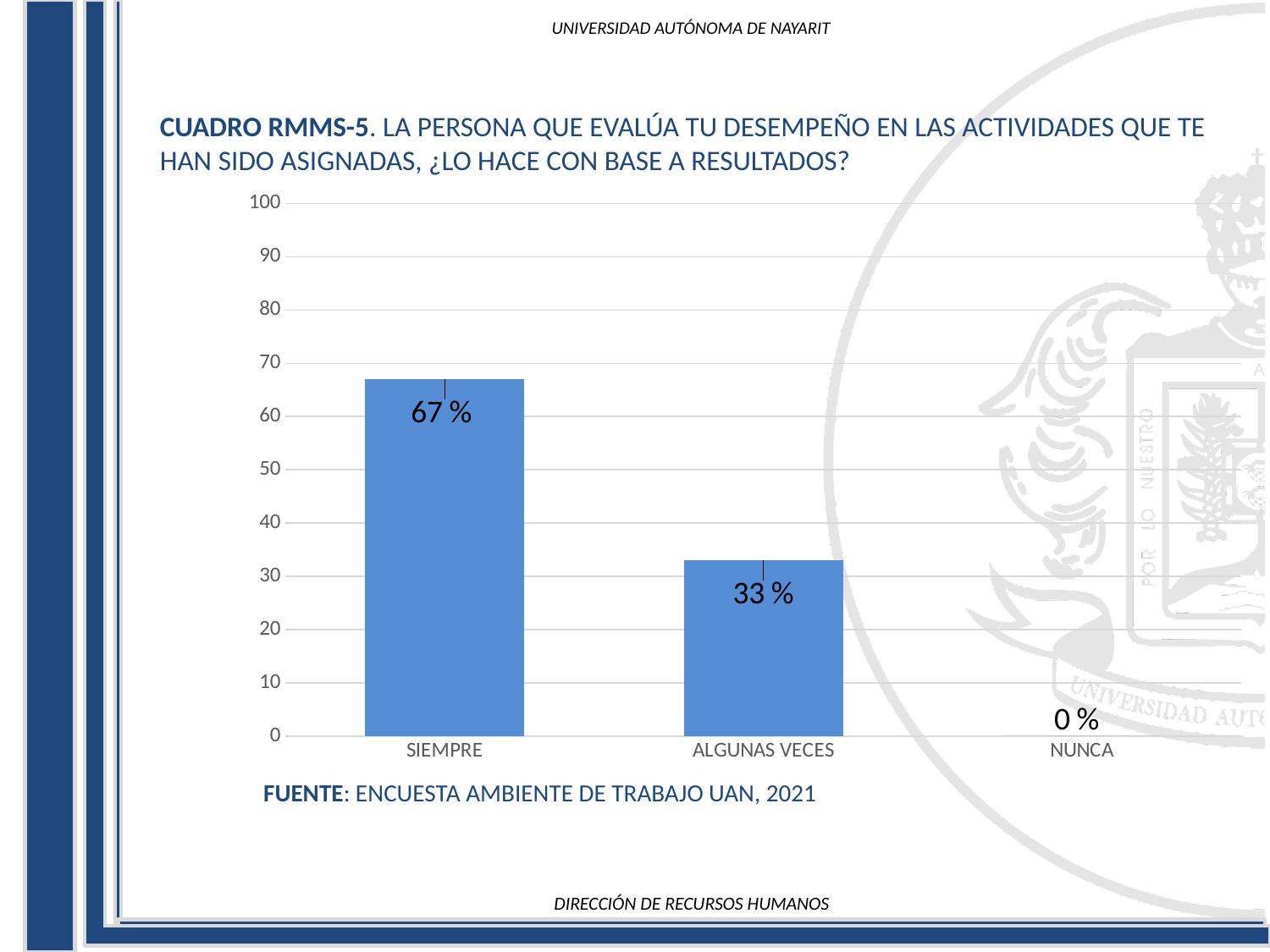
How many categories are shown on the x axis? 3 Which is larger, the value for SIEMPRE or the value for ALGUNAS VECES? SIEMPRE Is the value for SIEMPRE greater or less than 60? greater What is the value for SIEMPRE? 67 % What is the value for ALGUNAS VECES? 33 % What is the value for NUNCA? 0 % What is the difference between the values for SIEMPRE and ALGUNAS VECES? 34 % Which category has the lowest value? NUNCA What is the source cited below the chart? ENCUESTA AMBIENTE DE TRABAJO UAN, 2021 Which category has the highest value? SIEMPRE What kind of chart is shown on the slide? bar chart Is the value for ALGUNAS VECES greater or less than 40? less